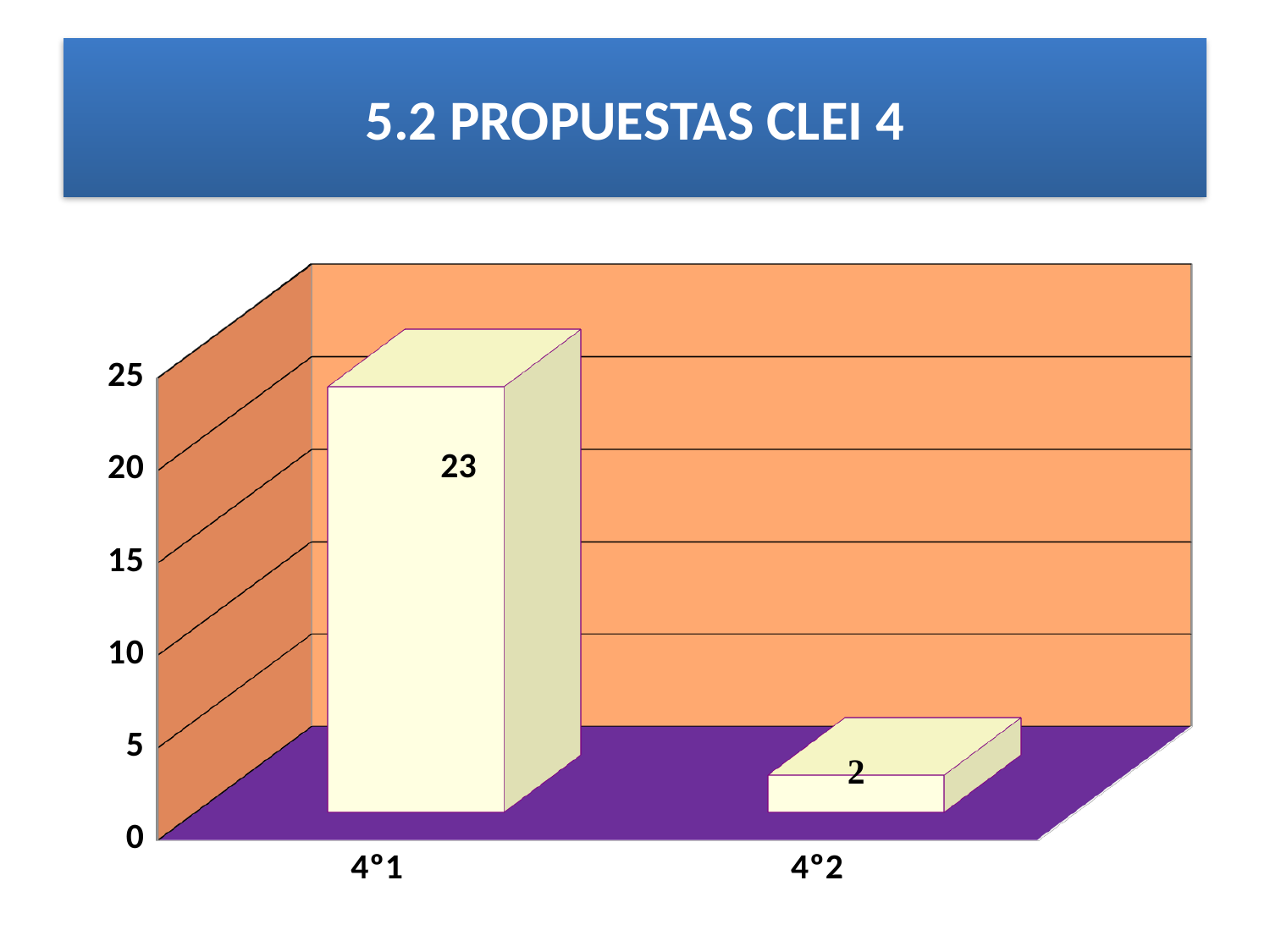
What is the value for 4°1? 23 Is the value for 4°1 greater or less than 20? greater What is the value for 4°2? 2 Which category has the lowest value? 4°2 What is the highest value shown on the vertical axis? 25 Is the value for 4°2 greater or less than 5? less Which category has the highest value? 4°1 How many categories are shown on the x axis? 2 What is the title of the slide? 5.2 PROPUESTAS CLEI 4 What kind of chart is shown on the slide? bar chart What is the difference between the values for 4°1 and 4°2? 21 Which is larger, the value for 4°1 or the value for 4°2? 4°1